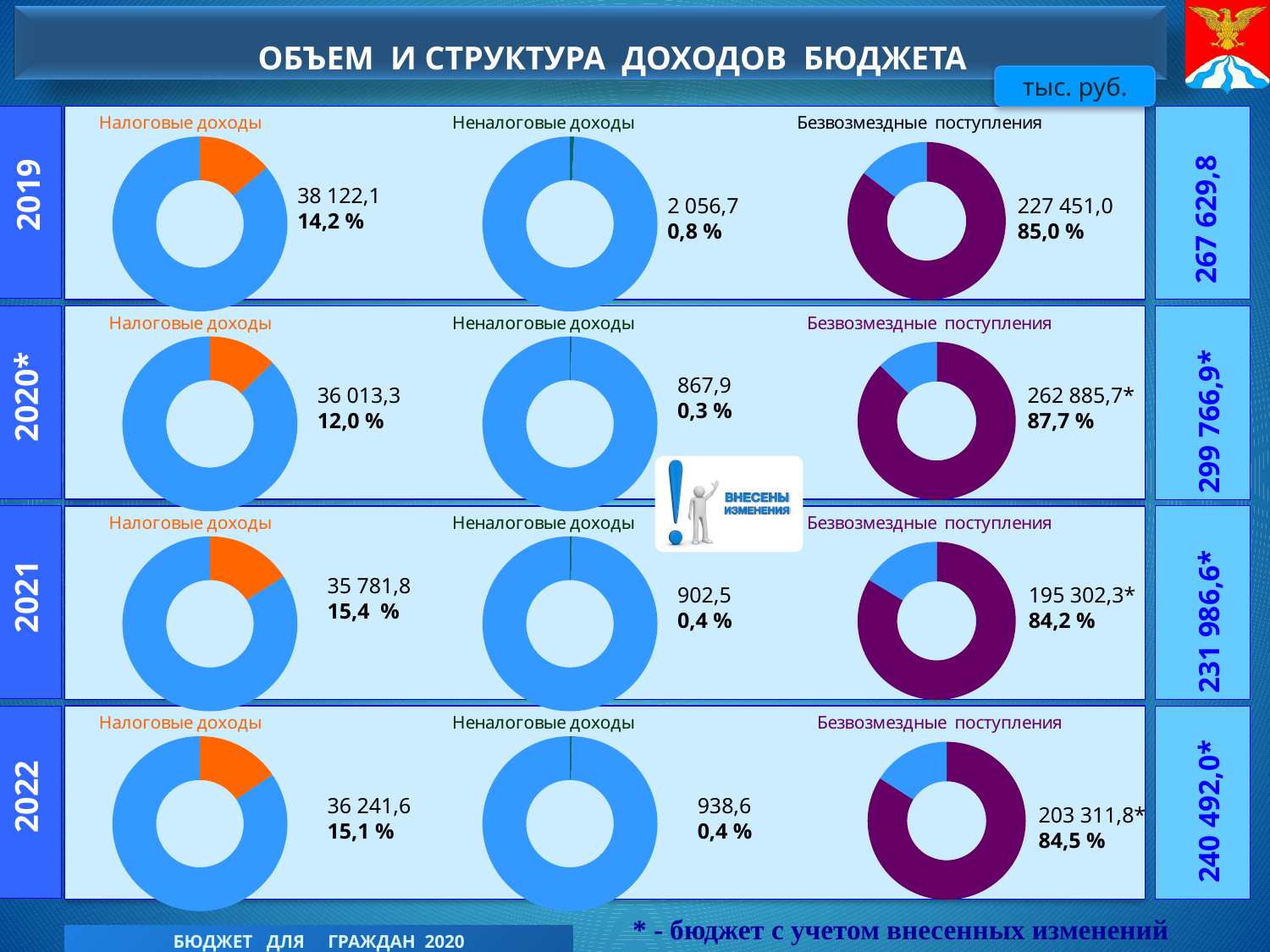
What type of chart is used for each of the twelve charts on the slide? Donut (pie) chart In the 2020* row, what value is shown for the Неналоговые доходы donut chart? 867,9 What total value is shown at the right end of the 2021 row? 231 986,6* Across the four rows, which year has the lowest percentage for Неналоговые доходы? 2020* In the 2019 row, what percentage is shown for the Безвозмездные поступления donut chart? 85,0 % What is the difference between the Налоговые доходы percentage in 2021 and in 2020*? 3,4 % How many donut charts are shown in the 2022 row? 3 In the 2021 row, what percentage is shown for the Налоговые доходы donut chart? 15,4 % In the 2022 row, what value is shown for the Безвозмездные поступления donut chart? 203 311,8* Across the four rows, which year has the highest percentage for Безвозмездные поступления? 2020* In the 2019 row, which is larger: the value for Налоговые доходы or the value for Неналоговые доходы? Налоговые доходы In the 2019 row, what value is shown for the Налоговые доходы donut chart? 38 122,1